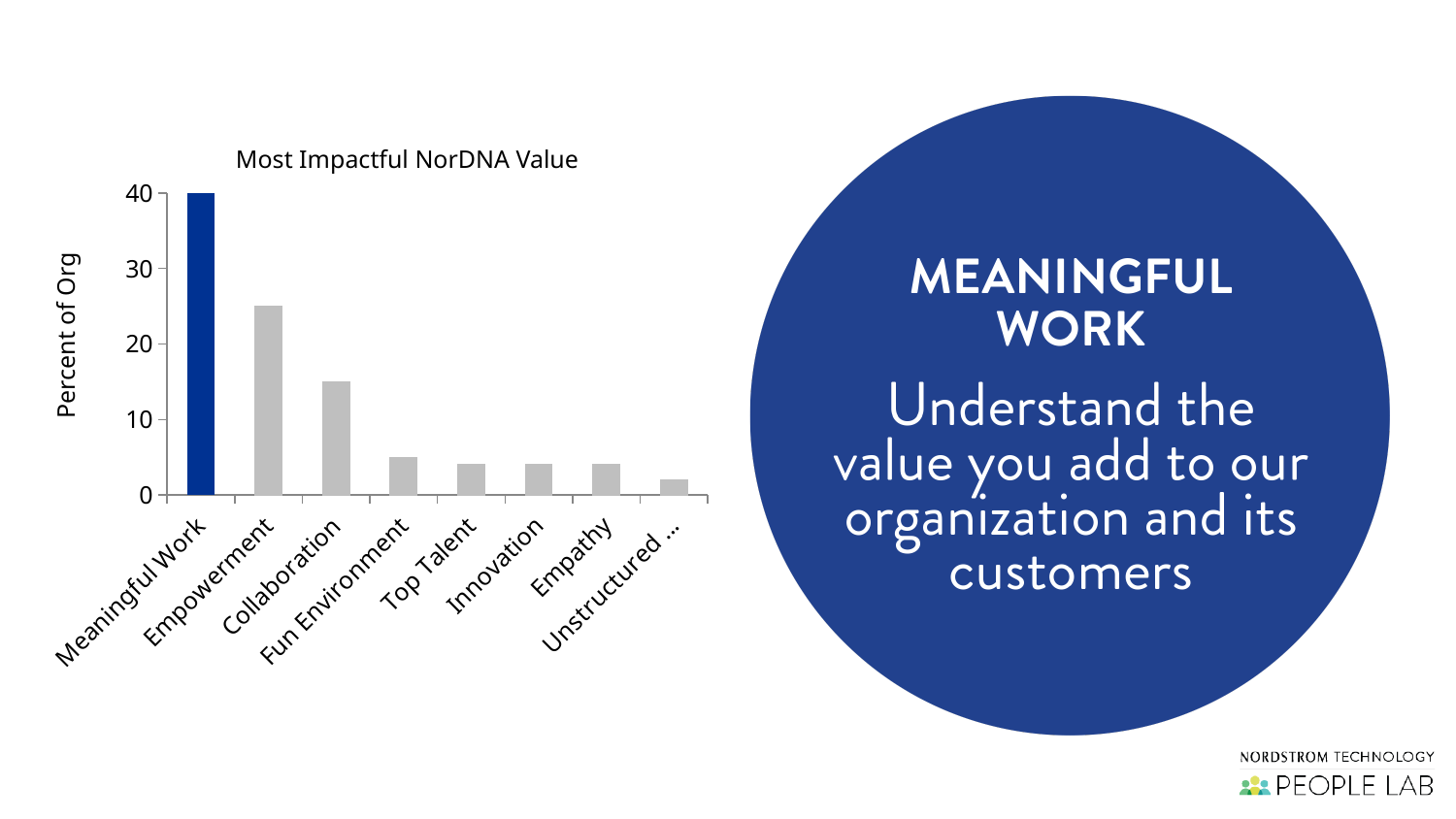
What kind of chart is shown on the slide? bar chart What is the label on the y axis of the chart? Percent of Org Is the value for Fun Environment greater or less than 10? less Is the value for Collaboration greater or less than 10? greater Which is larger, the value for Empowerment or the value for Collaboration? Empowerment Is the value for Empowerment greater or less than 30? less Do the values in the chart rise or fall moving from left to right along the x axis? fall What is the title of the chart on the slide? Most Impactful NorDNA Value What is the value for Meaningful Work in the Most Impactful NorDNA Value chart? 40 Which category has the highest value in the Most Impactful NorDNA Value chart? Meaningful Work How many categories are shown on the x axis of the chart? 8